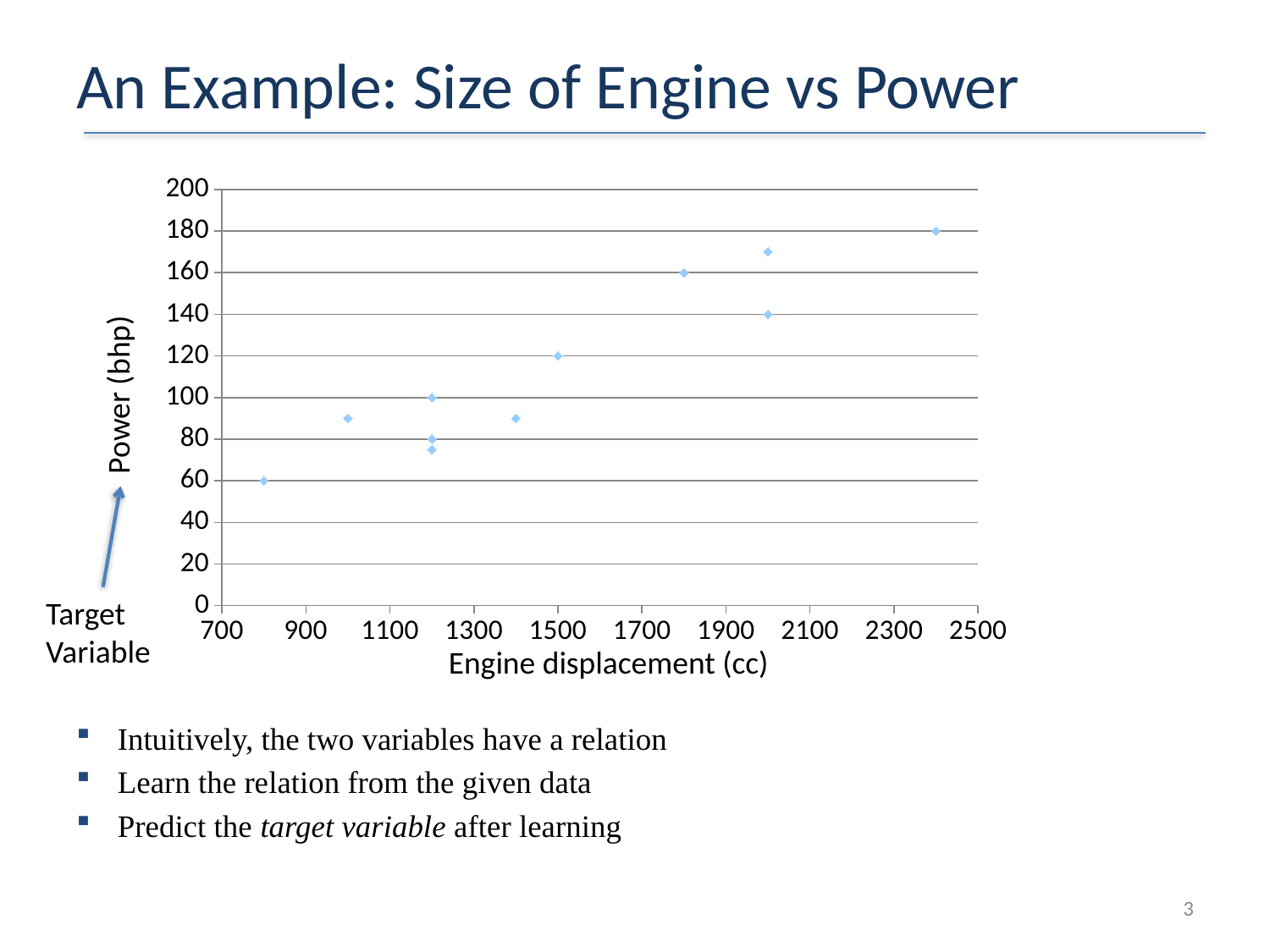
What is the power (bhp) of the point at 2400 cc engine displacement? 180 What kind of chart is shown on the slide? Scatter chart What is the power (bhp) of the point at 1500 cc engine displacement? 120 What is the label of the vertical axis? Power (bhp) Is the power for the point at 1000 cc greater or less than 80? greater How many data points are plotted in the chart? 11 What is the power (bhp) of the point at 1800 cc engine displacement? 160 What is the power (bhp) of the point at 800 cc engine displacement? 60 Overall, does power rise or fall as engine displacement increases? Rises What is the label of the horizontal axis? Engine displacement (cc)